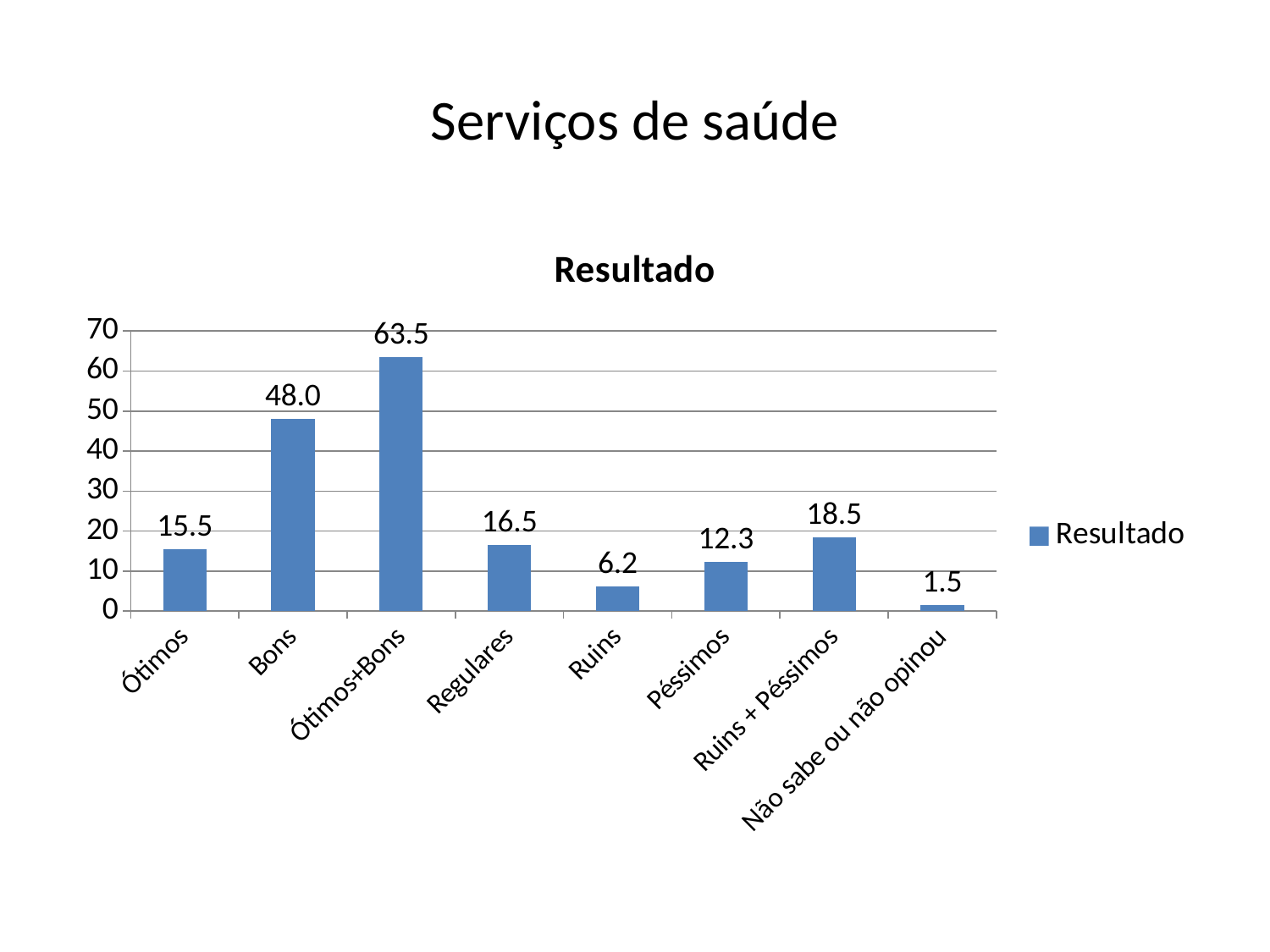
What kind of chart is shown on the slide? bar chart What is the difference between the values for Ótimos+Bons and Bons? 15.5 What is the difference between the values for Regulares and Ruins? 10.3 Which category has the lowest value? Não sabe ou não opinou What is the value for Ruins + Péssimos? 18.5 Which is larger, the value for Péssimos or the value for Ruins? Péssimos Which category has the highest value? Ótimos+Bons What is the value for Ótimos? 15.5 What is the value for Bons? 48.0 What is the value for Não sabe ou não opinou? 1.5 What is the title of the chart? Resultado How many categories are shown on the x axis? 8